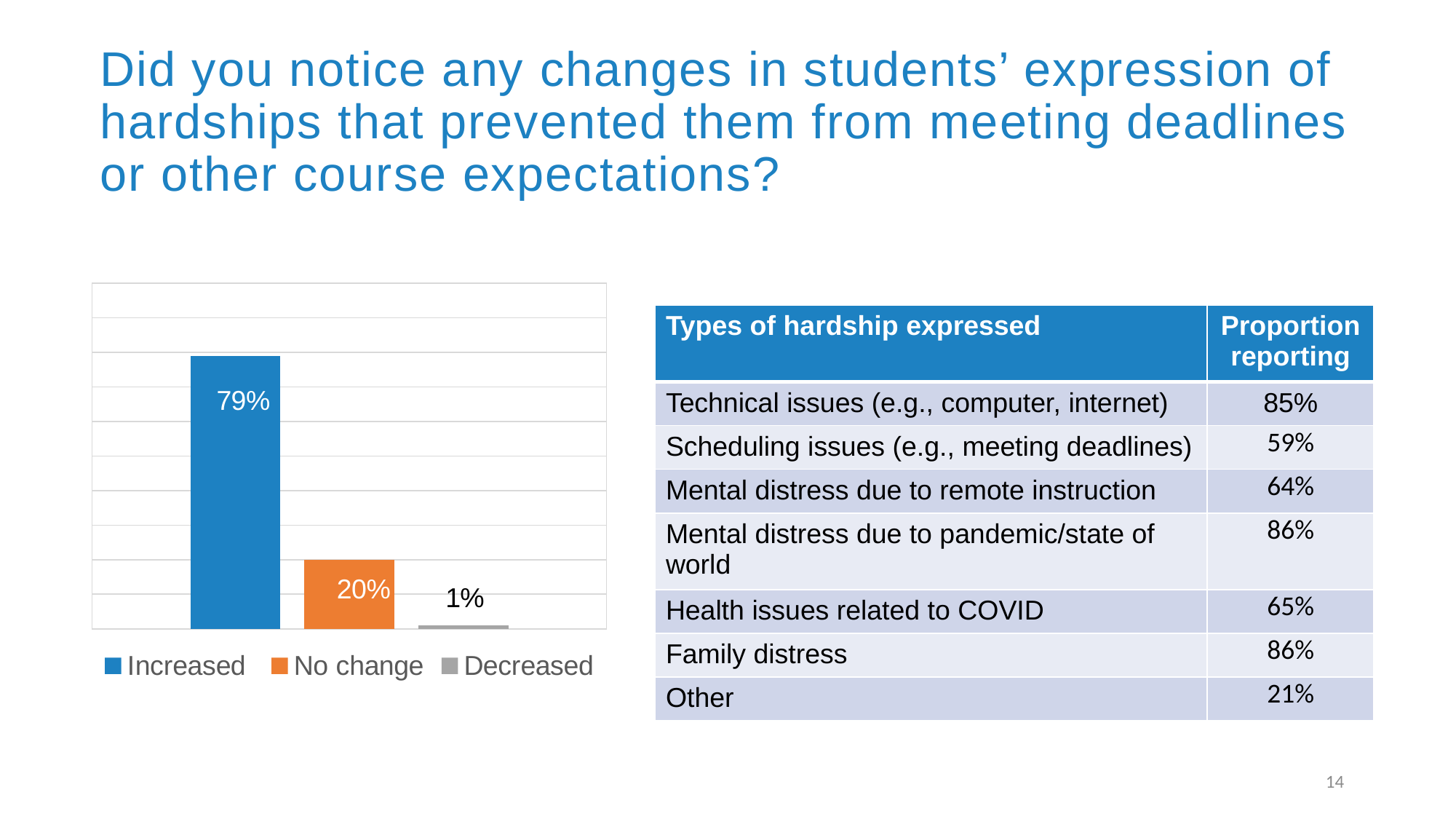
What is the value for Increased in the bar chart? 79% What is the value for Decreased in the bar chart? 1% How many series does the legend of the bar chart list? 3 Which is larger in the bar chart, the value for No change or the value for Decreased? No change Which category has the lowest value in the bar chart? Decreased What is the difference between the values for Increased and No change in the bar chart? 59% Which category has the highest value in the bar chart? Increased What is the value for No change in the bar chart? 20% What is the difference between the values for No change and Decreased in the bar chart? 19% What colour is the bar for No change in the bar chart? orange How many bars are plotted in the bar chart? 3 What kind of chart is shown on the slide? bar chart